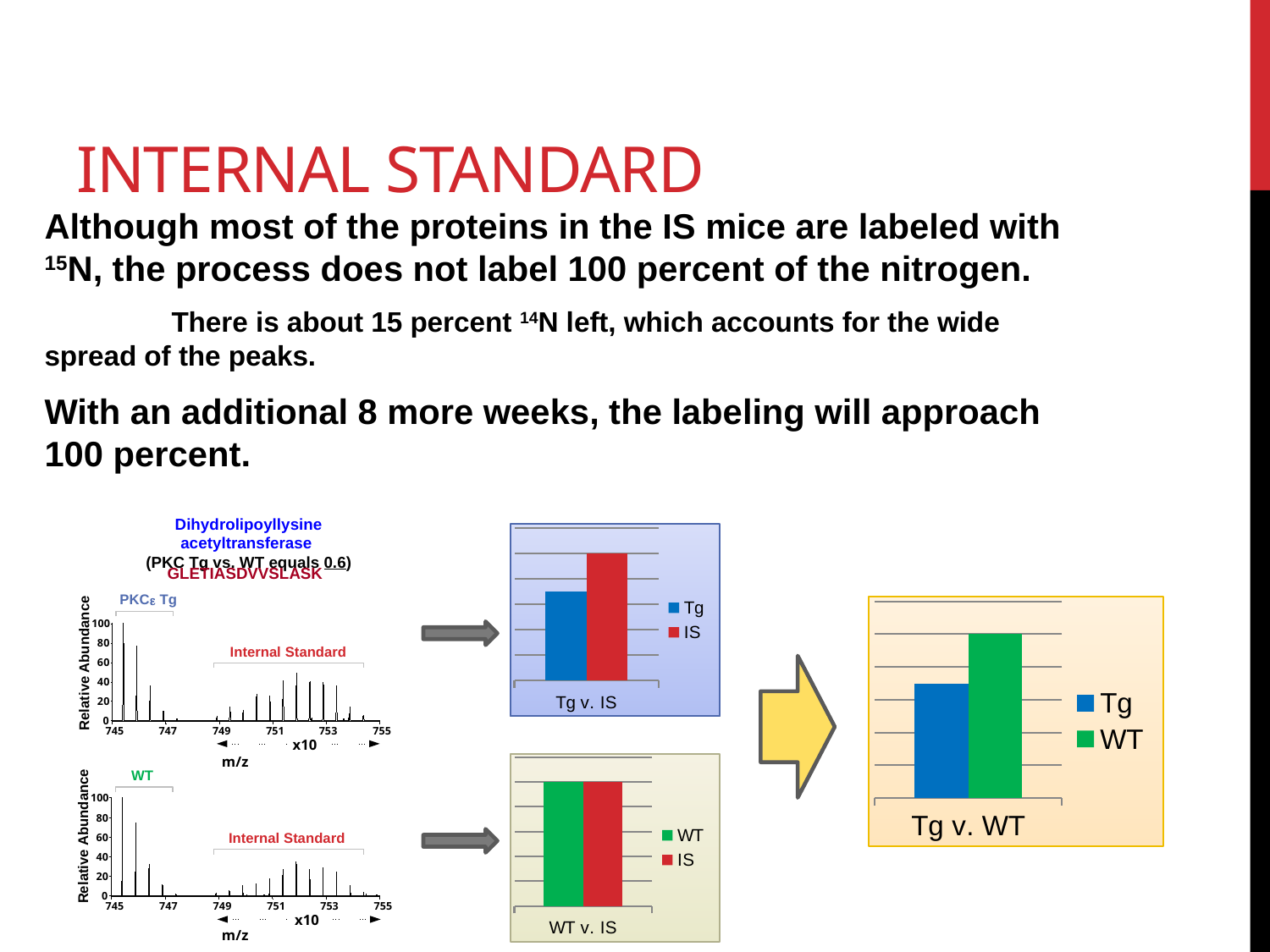
In the chart titled "Tg v. IS", which series has the lowest bar? Tg In the chart titled "WT v. IS", how many bars are plotted? 2 How many bar charts are shown on the slide? 3 In the chart titled "Tg v. WT", which series has the highest bar? WT In the chart titled "Tg v. IS", which bar is taller, Tg or IS? IS In the chart titled "Tg v. WT", which bar is taller, Tg or WT? WT In the chart titled "Tg v. IS", what kind of chart is shown? bar chart In the chart titled "Tg v. IS", how many series does the legend list? 2 In the chart titled "WT v. IS", what are the two series listed in the legend? WT and IS In the chart titled "Tg v. WT", what colour is the WT bar? green In the chart titled "WT v. IS", what kind of chart is shown? bar chart In the chart titled "Tg v. WT", how many series does the legend list? 2